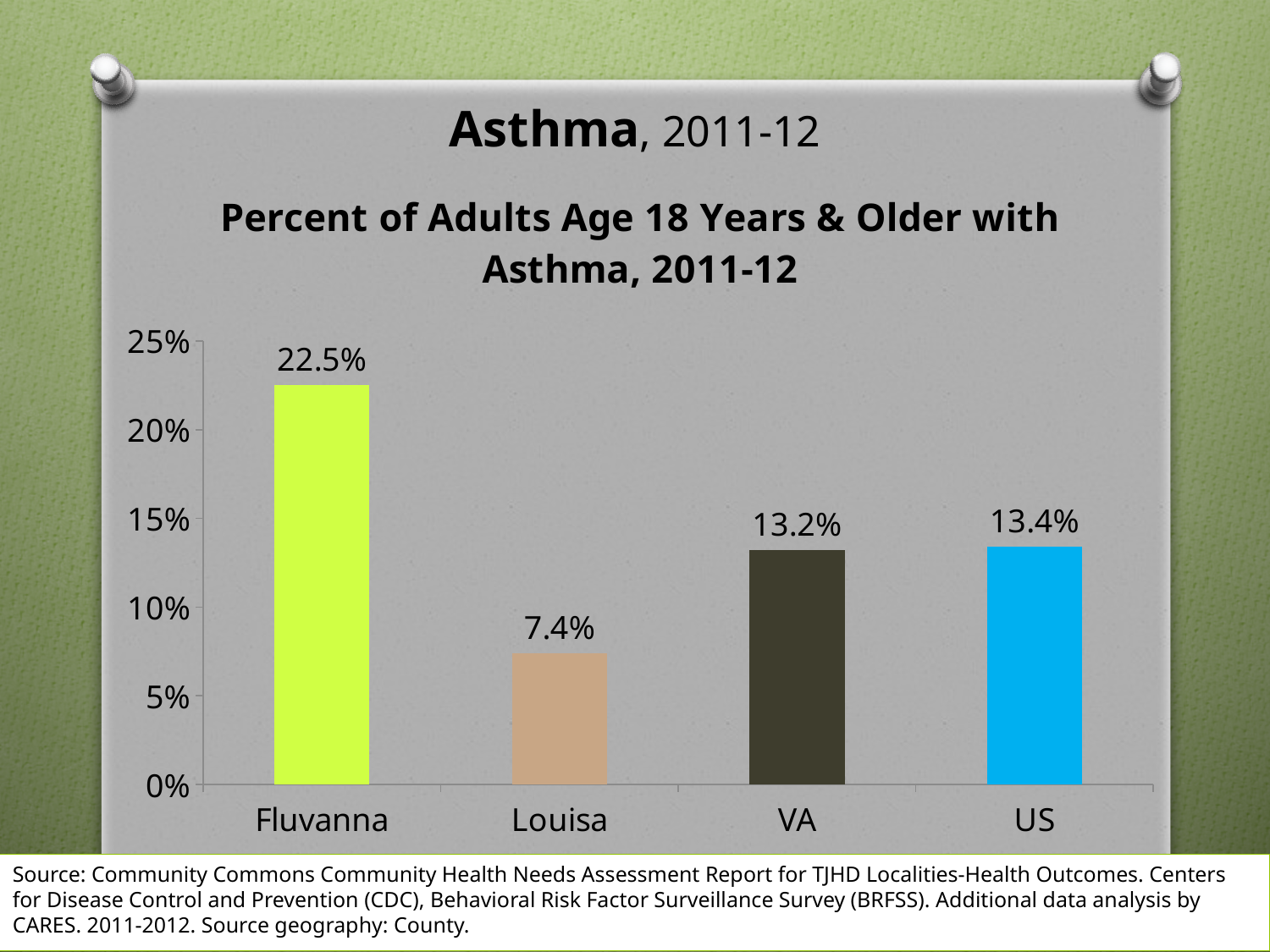
How many categories are shown on the x axis? 4 Which category has the highest value? Fluvanna Is the value for Louisa greater or less than 10%? less What is the value for US? 13.4% What is the difference between the values for US and VA? 0.2% What is the value for VA? 13.2% What is the difference between the values for Fluvanna and Louisa? 15.1% What kind of chart is shown on the slide? bar chart What is the value for Louisa? 7.4% What is the value for Fluvanna? 22.5% Which is larger, the value for Fluvanna or the value for US? Fluvanna Which category has the lowest value? Louisa